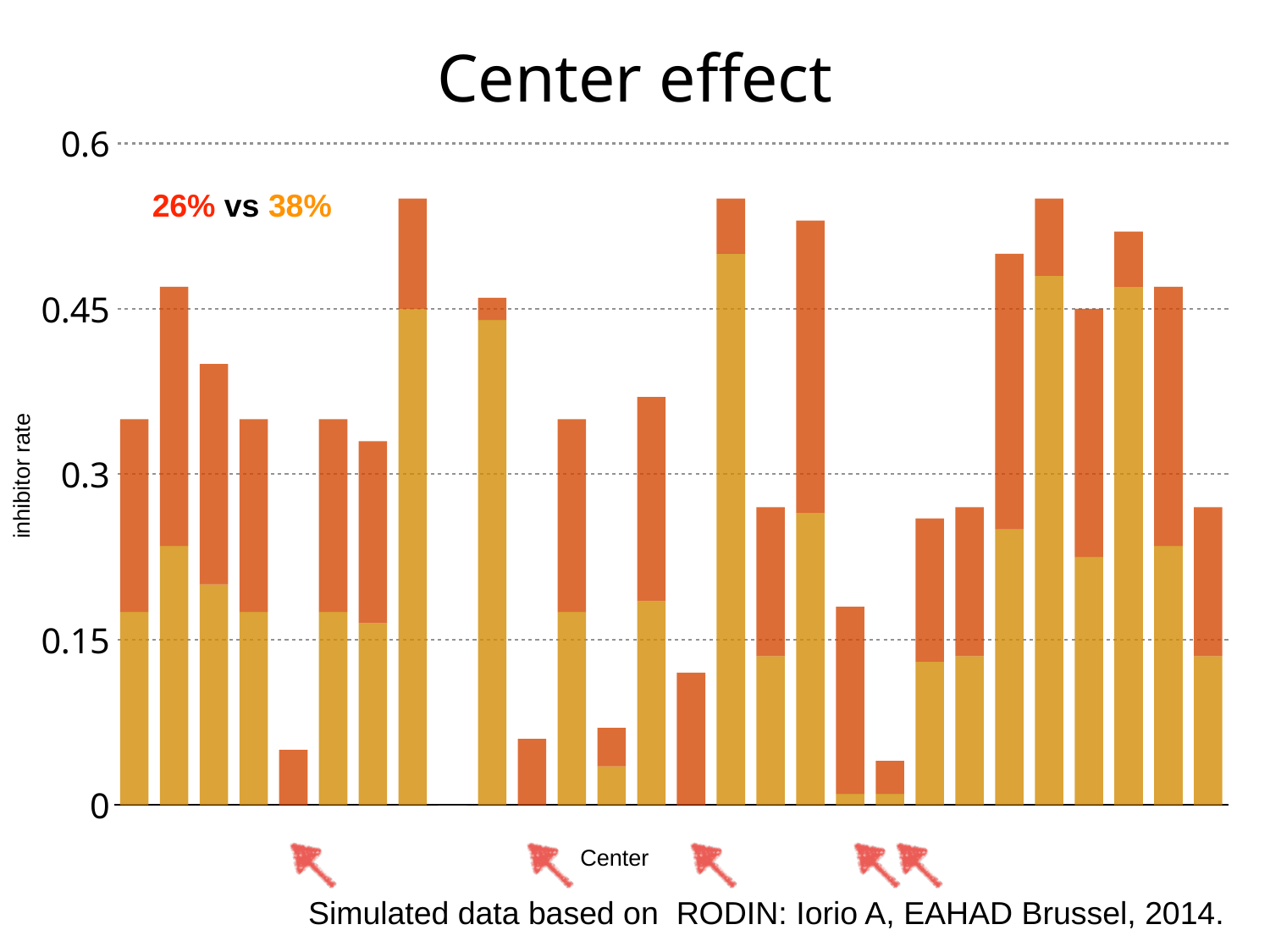
Is the value of the tallest bar in the chart greater or less than 0.45? greater What is the highest value shown on the vertical axis of the chart? 0.6 Is the value of the shortest bar in the chart greater or less than 0.15? less What kind of chart is shown on the slide? bar chart Is the value of the first bar from the left greater or less than 0.3? greater What is the title of the chart? Center effect What is the label on the vertical axis of the chart? inhibitor rate